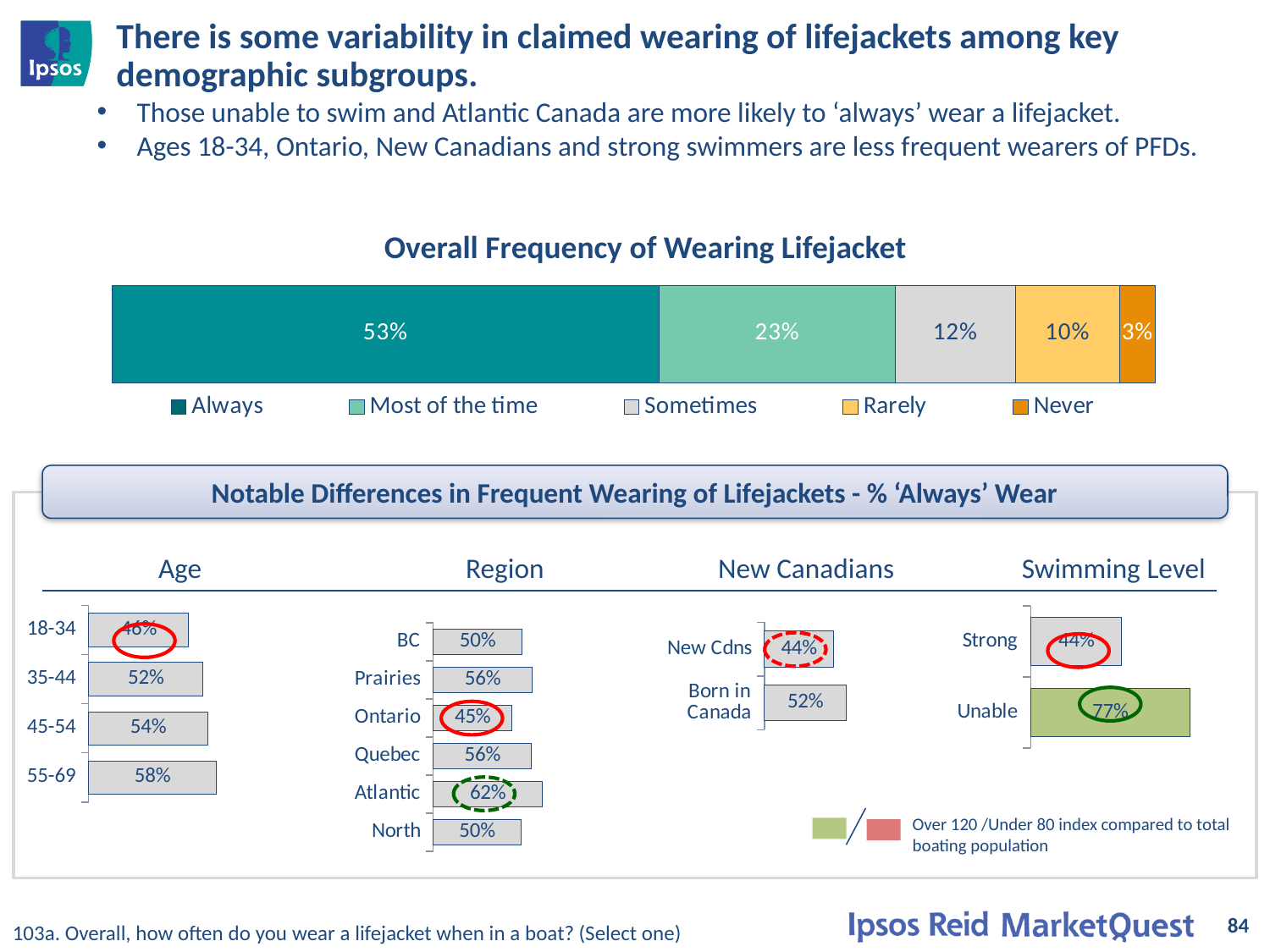
How many regions are shown in the Region chart? 6 In the New Canadians chart, which group has the larger value: New Cdns or Born in Canada? Born in Canada In the Age chart, what percentage of those aged 55-69 'always' wear a lifejacket? 58% In the Region chart, what is the value for Ontario? 45% In the Region chart, which region has the highest percentage of 'always' wearing a lifejacket? Atlantic In the Overall Frequency of Wearing Lifejacket chart, what is the difference between the 'Most of the time' and 'Sometimes' percentages? 11% How many series does the legend of the Overall Frequency of Wearing Lifejacket chart list? 5 In the Overall Frequency of Wearing Lifejacket chart, what percentage say they 'Never' wear a lifejacket? 3% In the Overall Frequency of Wearing Lifejacket chart, what percentage of respondents say they 'Always' wear a lifejacket? 53% What type of chart is the Overall Frequency of Wearing Lifejacket chart? Stacked bar chart In the Age chart, which age group has the lowest percentage of 'always' wearing a lifejacket? 18-34 In the Swimming Level chart, what is the difference between the 'Unable' and 'Strong' values? 33%